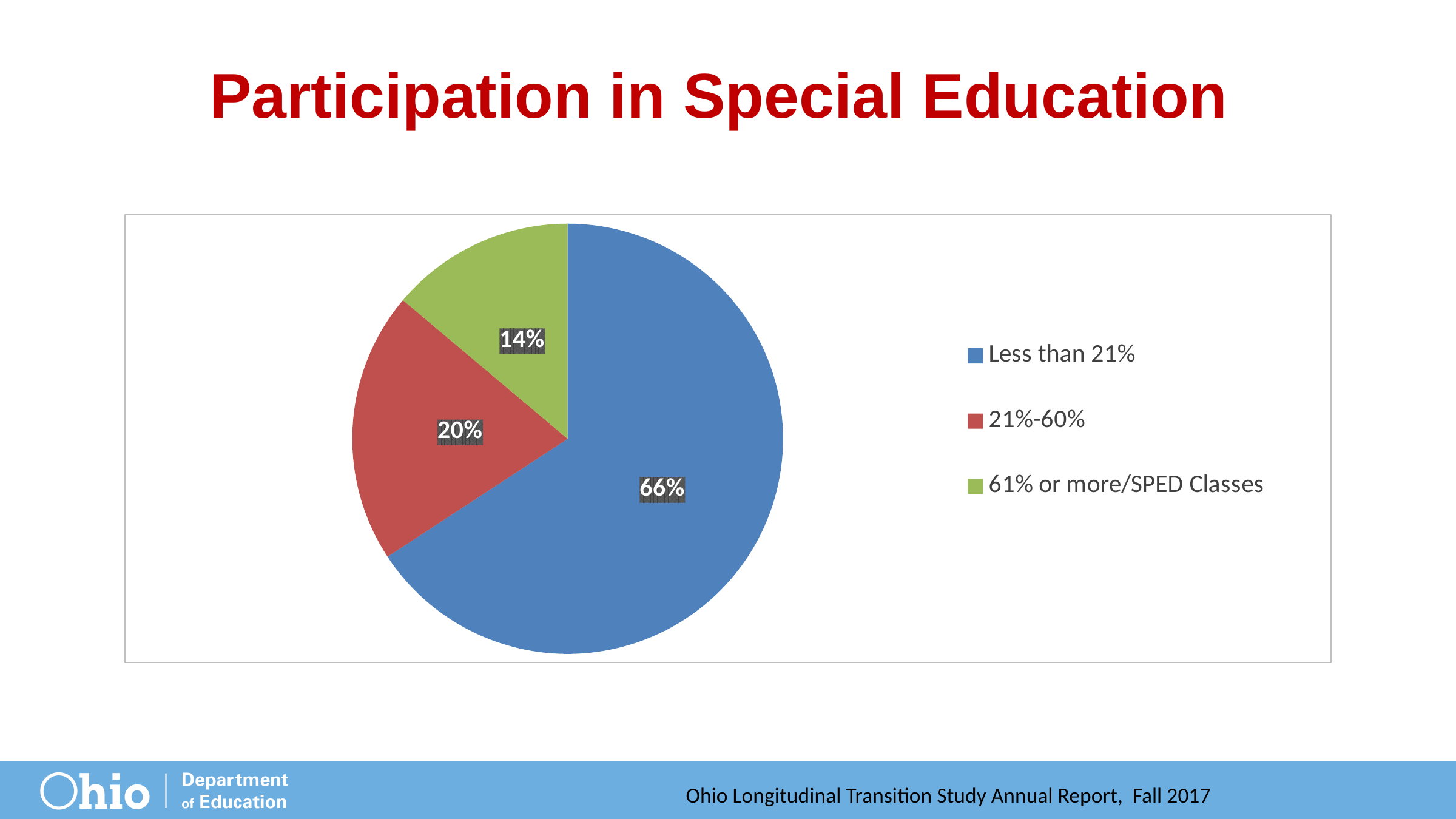
What share of the pie is labelled "61% or more/SPED Classes"? 14% What share of the pie is labelled "Less than 21%"? 66% Which category has the smallest slice of the pie? 61% or more/SPED Classes What colour is the slice for "61% or more/SPED Classes"? Green What is the title of the slide containing the chart? Participation in Special Education What share of the pie is labelled "21%-60%"? 20% What is the difference in percentage points between the "21%-60%" slice and the "61% or more/SPED Classes" slice? 6 What is the difference in percentage points between the "Less than 21%" slice and the "21%-60%" slice? 46 What kind of chart is shown on the slide? Pie chart Which is larger, the "21%-60%" slice or the "61% or more/SPED Classes" slice? 21%-60% Which category has the largest slice of the pie? Less than 21% How many categories are shown in the pie chart? 3